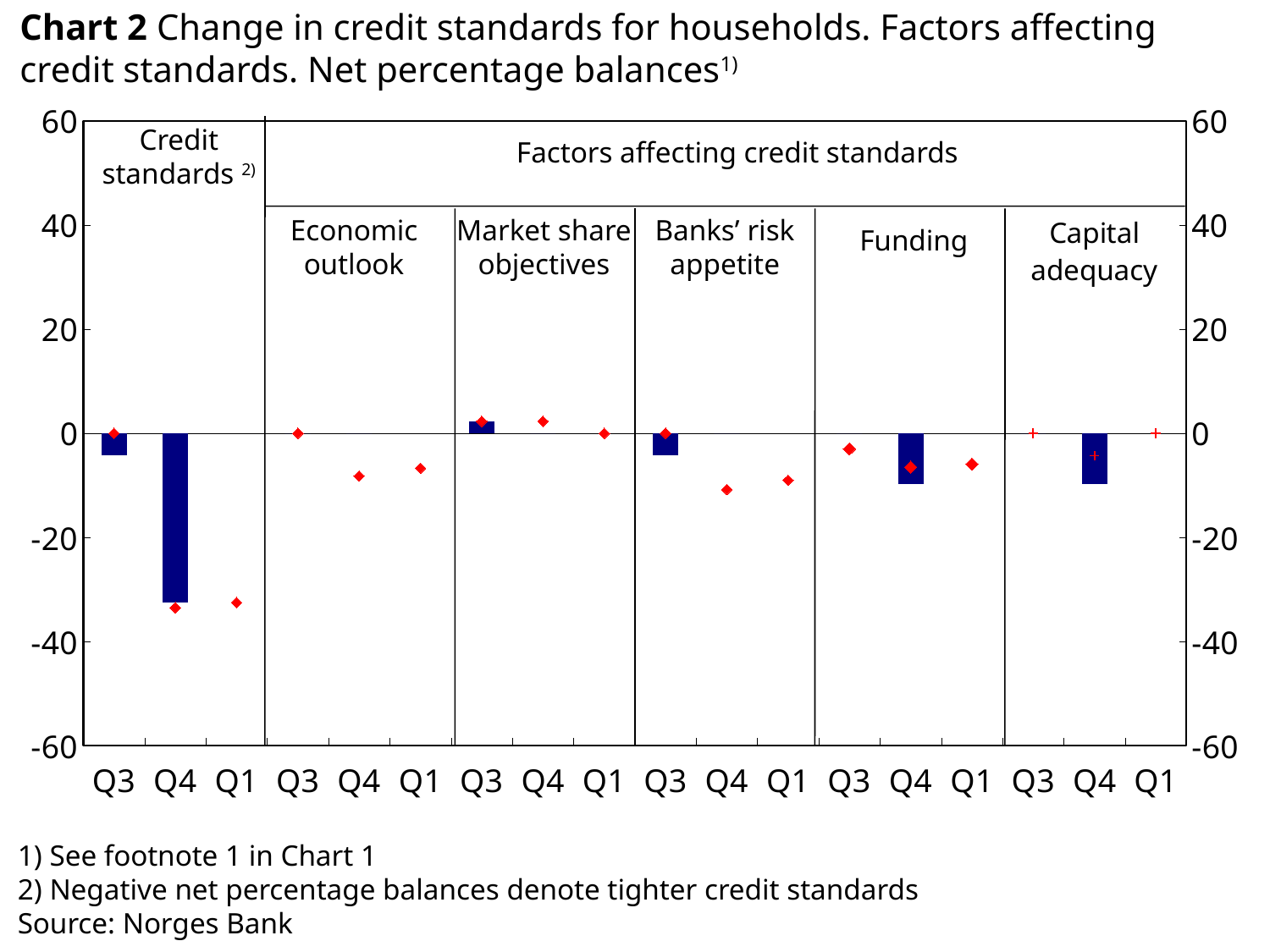
Is the Q4 bar in the Credit standards panel greater or less than -40? greater Does the Credit standards value rise or fall from Q3 to Q4? fall What kind of chart is shown on the slide? combination bar and line chart (bars with point markers) What is the source given for the chart? Norges Bank Which panel contains the lowest bar on the chart? Credit standards Which is larger, the Q4 bar in the Credit standards panel or the Q4 bar in the Funding panel? Funding Q4 Is the Q3 bar in the Market share objectives panel greater or less than 0? greater How many factor panels are shown under "Factors affecting credit standards"? 5 Is the Q4 bar in the Funding panel greater or less than -20? greater In the Credit standards panel, which quarter has the lowest bar? Q4 How many quarters are shown on the x axis within each panel? 3